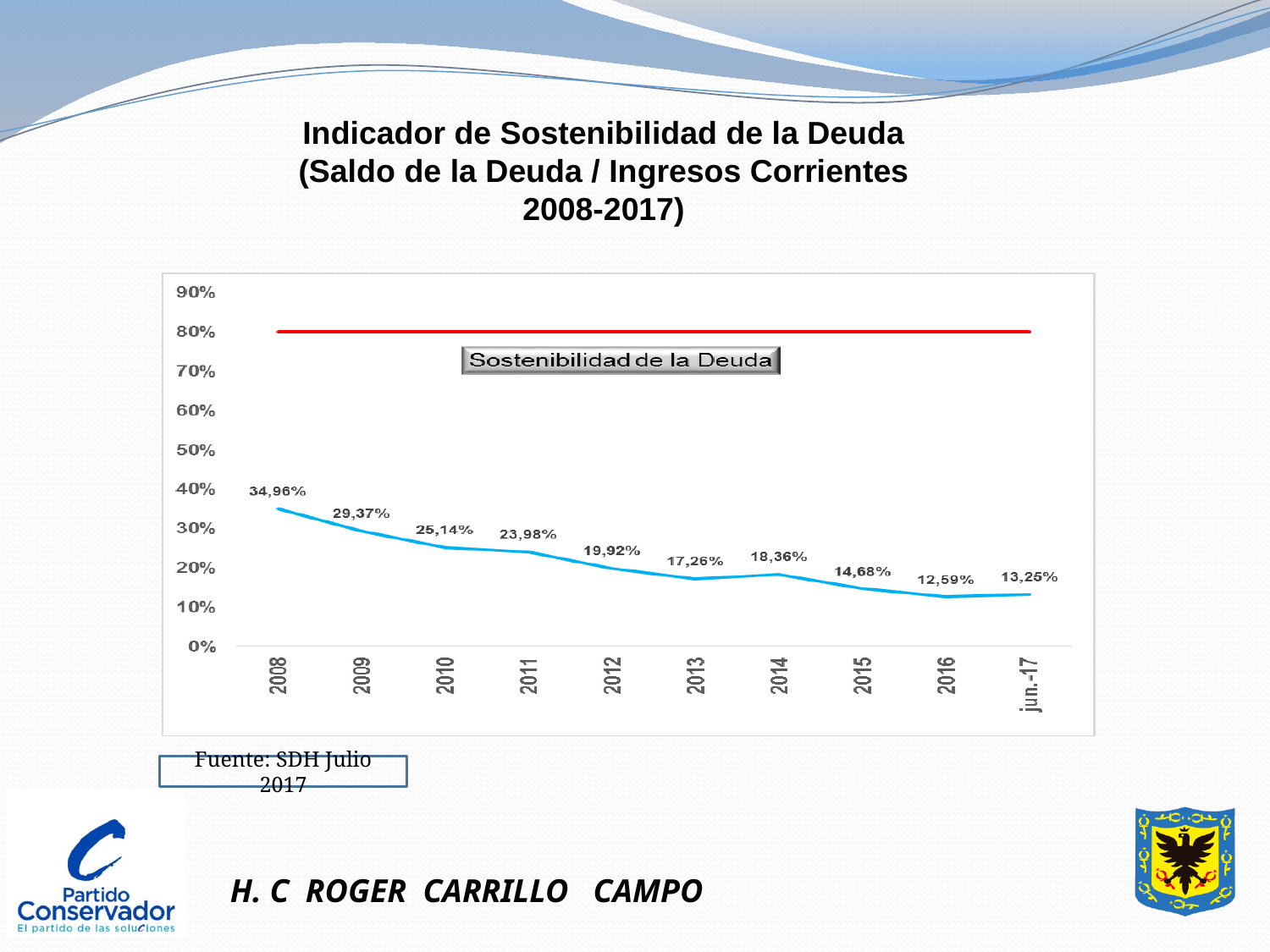
Is the value for 2010 greater or less than 20%? greater What is the value of Sostenibilidad de la Deuda for 2008? 34,96% What is the value of Sostenibilidad de la Deuda for jun.-17? 13,25% Does the Sostenibilidad de la Deuda line generally rise or fall from 2008 to jun.-17? fall How many data points are plotted on the blue line? 10 Which year has the highest value of Sostenibilidad de la Deuda? 2008 At what level is the horizontal red line drawn on the chart? 80% What kind of chart is shown on the slide? line chart What is the value of Sostenibilidad de la Deuda for 2014? 18,36% What is the difference between the 2008 value and the jun.-17 value? 21,71% Which is larger, the value for 2013 or the value for 2014? 2014 Which year has the lowest value of Sostenibilidad de la Deuda? 2016